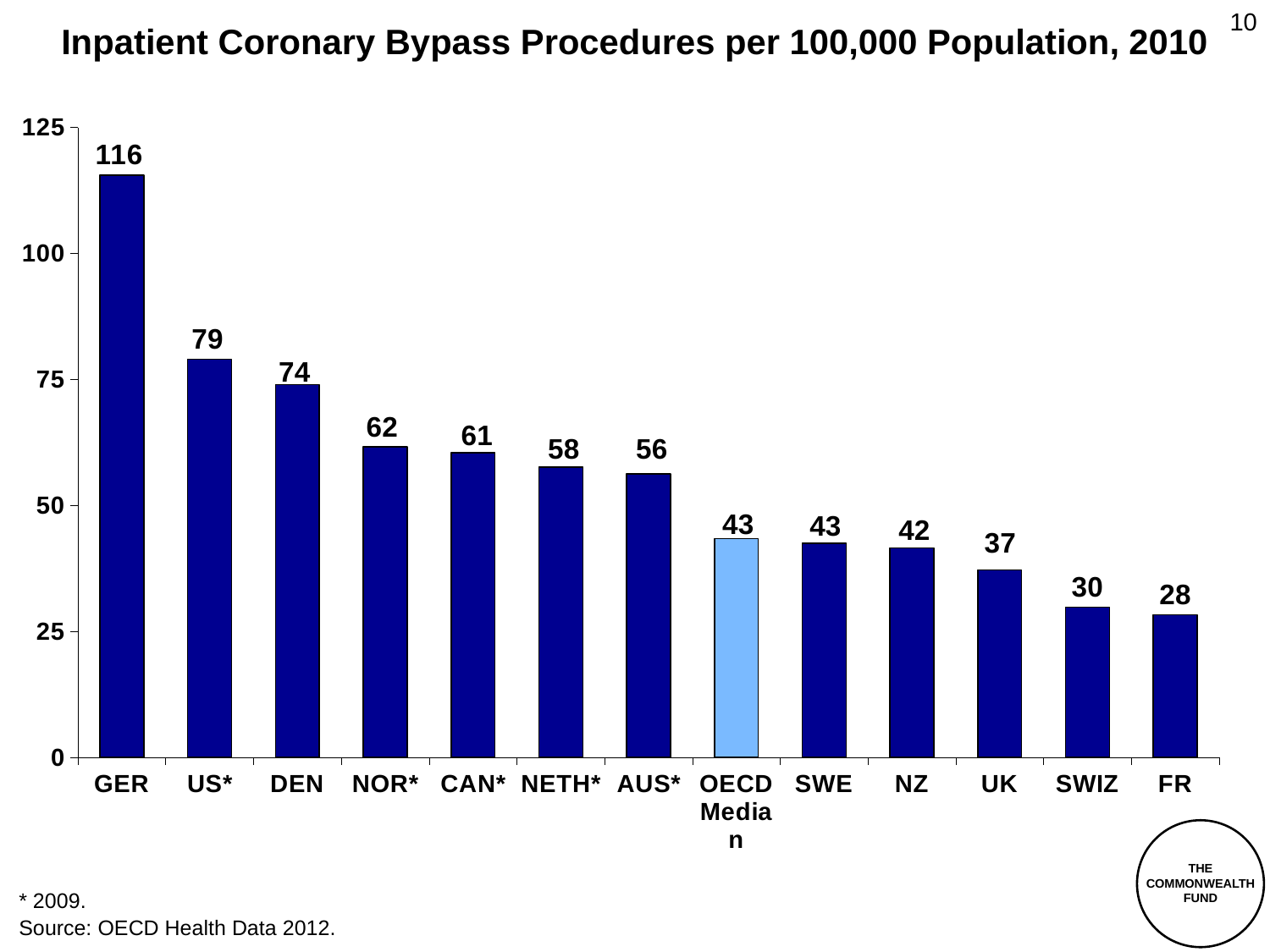
Is the value for CAN* greater or less than 50? greater What is the value for GER? 116 What is the difference between the values for GER and US*? 37 What kind of chart is this? bar chart What is the difference between the values for SWIZ and FR? 2 Which bar is shown in a lighter blue colour than the others? OECD Median What is the value for the OECD Median? 43 Which is larger, the value for DEN or the value for NOR*? DEN What is the value for UK? 37 How many categories are shown on the x axis? 13 Which category has the highest value? GER Which category has the lowest value? FR